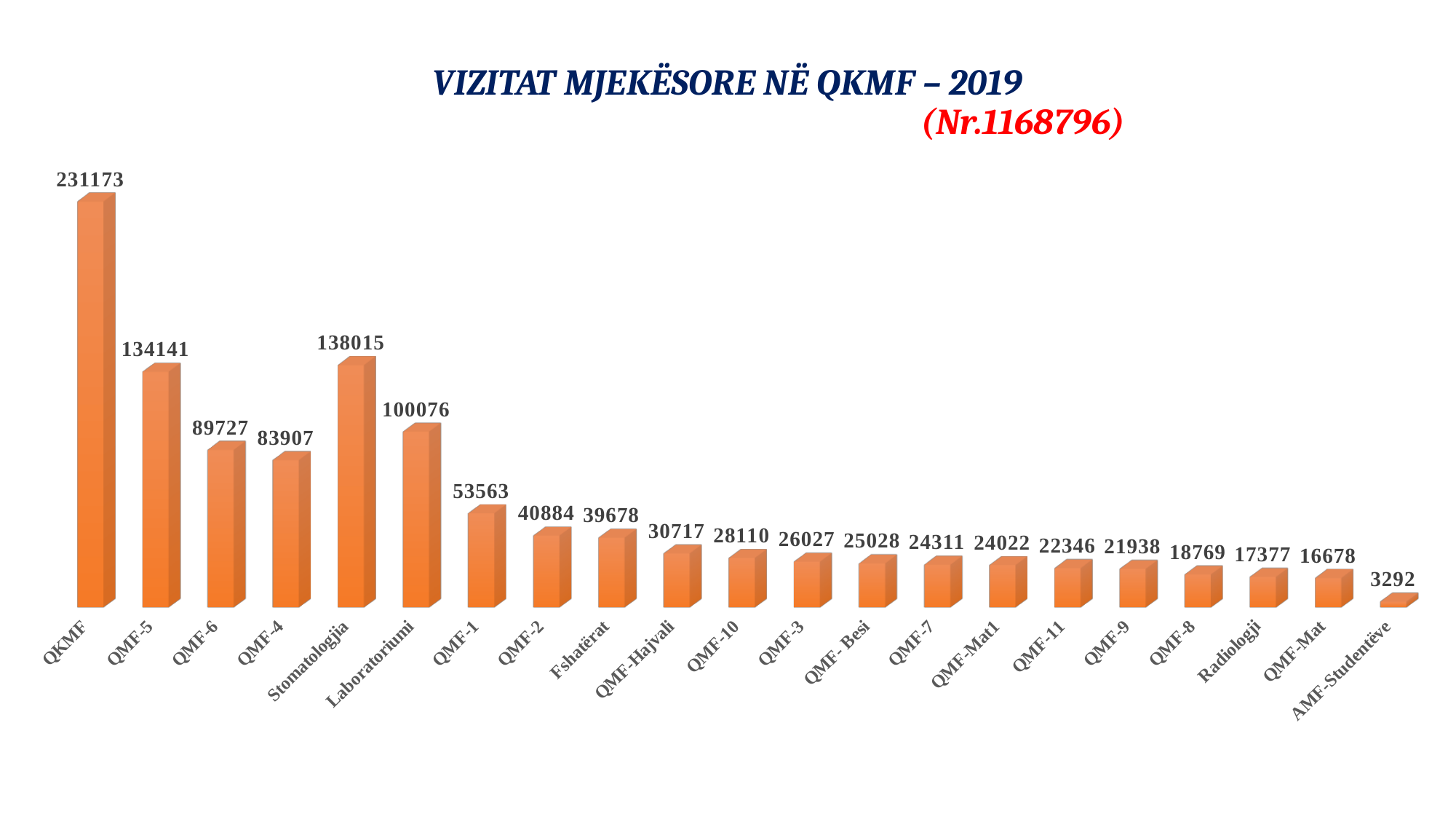
What is the difference between the values for QKMF and QMF-5? 97032 What kind of chart is shown on the slide? Bar chart What is the value for QMF-Hajvali? 30717 What is the value for Stomatologjia? 138015 What total number is shown in red below the chart title? Nr.1168796 Which is larger, the value for QMF-5 or the value for Stomatologjia? Stomatologjia What is the value for Radiologji? 17377 Which category has the highest value? QKMF What is the difference between the values for Stomatologjia and Laboratoriumi? 37939 What is the value for QKMF? 231173 Which category has the lowest value? AMF-Studentëve How many categories are shown in the chart? 21